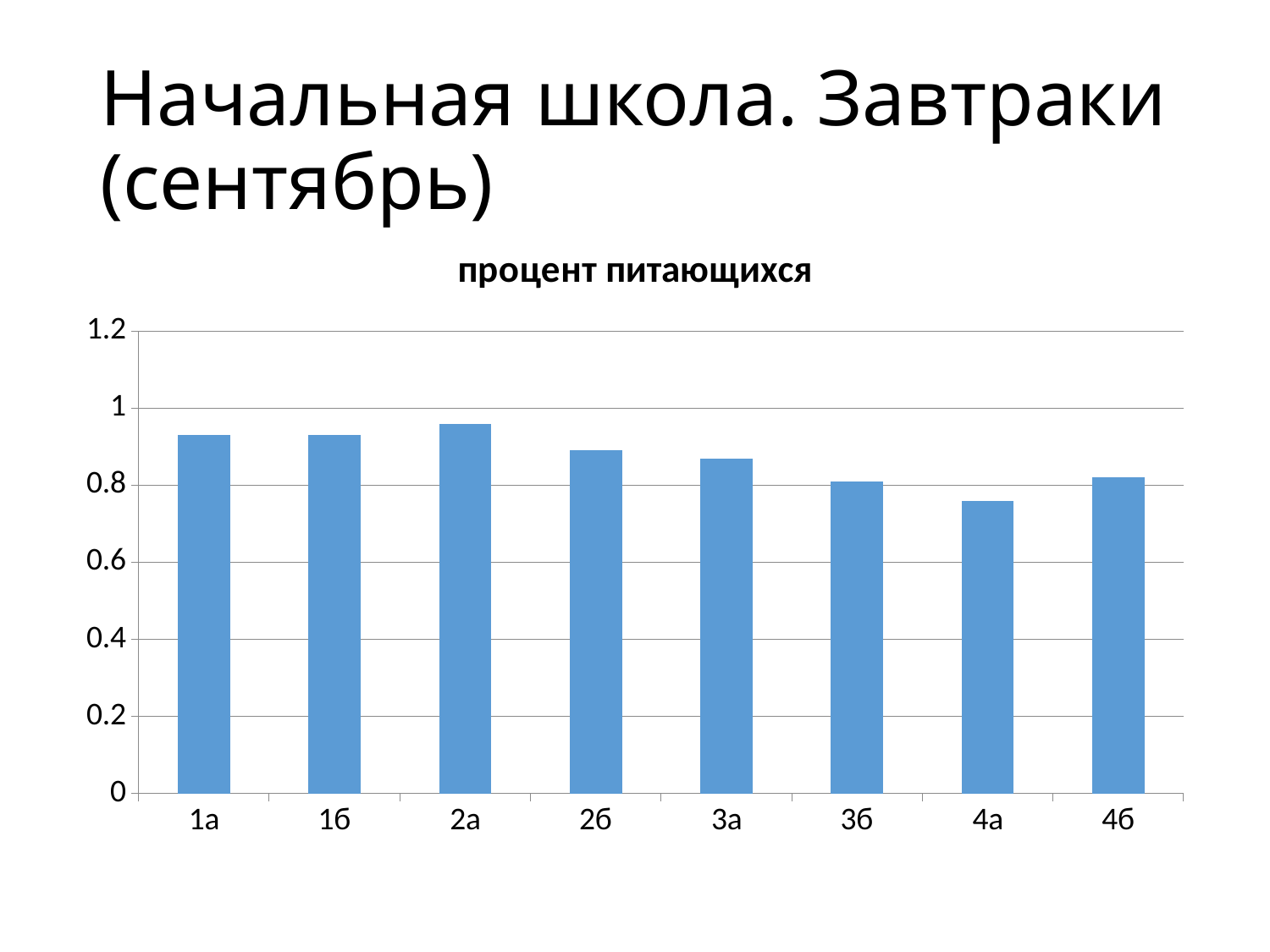
Which is larger, the value for 2а or the value for 4а? 2а Is the value for 1а greater or less than 0.8? greater Is the value for 3б greater or less than 0.6? greater What is the title of the chart? процент питающихся What kind of chart is shown on the slide? bar chart Which class has the lowest value? 4а Is the value for 2а greater or less than 1? less Which is larger, the value for 1б or the value for 3б? 1б How many classes (categories) are shown on the x axis? 8 Which class has the highest value? 2а What is the highest tick value shown on the vertical axis? 1.2